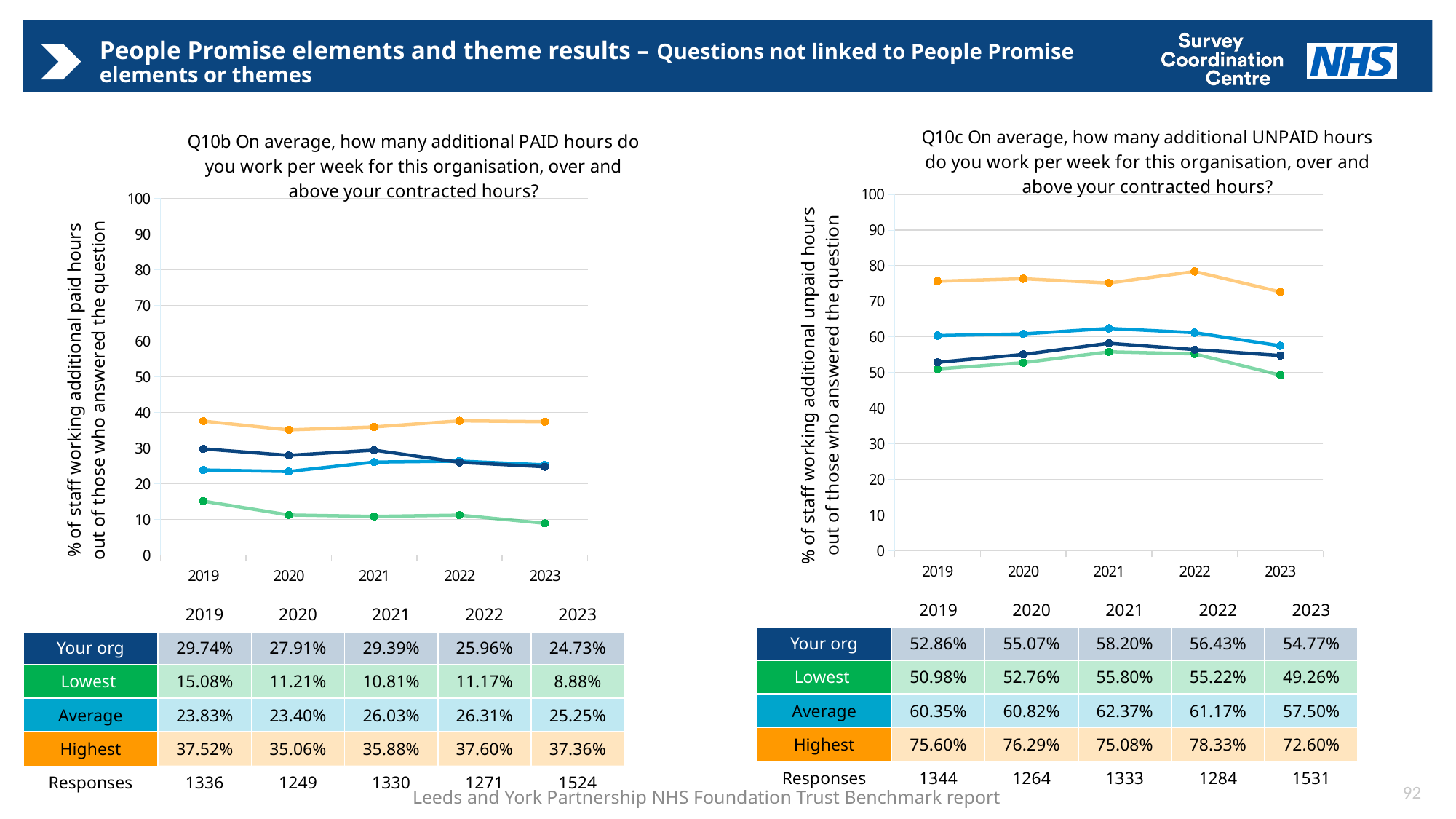
How many series are listed in the table below the Q10c UNPAID hours chart? 4 What type of chart is the Q10b PAID hours chart? Line chart In the Q10b PAID hours chart, what is the value for Your org in 2023? 24.73% In the Q10c UNPAID hours chart, what is the Highest value in 2022? 78.33% In the Q10c UNPAID hours chart, which is larger in 2020: Your org or Average? Average In the Q10b PAID hours chart, what is the difference between the Highest and Lowest values in 2019? 22.44% In the Q10c UNPAID hours chart, does the Average series rise or fall from 2022 to 2023? Fall In the Q10b PAID hours chart, is the Highest value in 2022 greater or less than 30? greater In the Q10c UNPAID hours chart, in which year does Your org reach its highest value? 2021 In the Q10b PAID hours chart, what is the difference between Your org and Average in 2021? 3.36% How many years are plotted on the x axis of the Q10c UNPAID hours chart? 5 In the Q10b PAID hours chart, in which year is the Lowest series at its lowest value? 2023